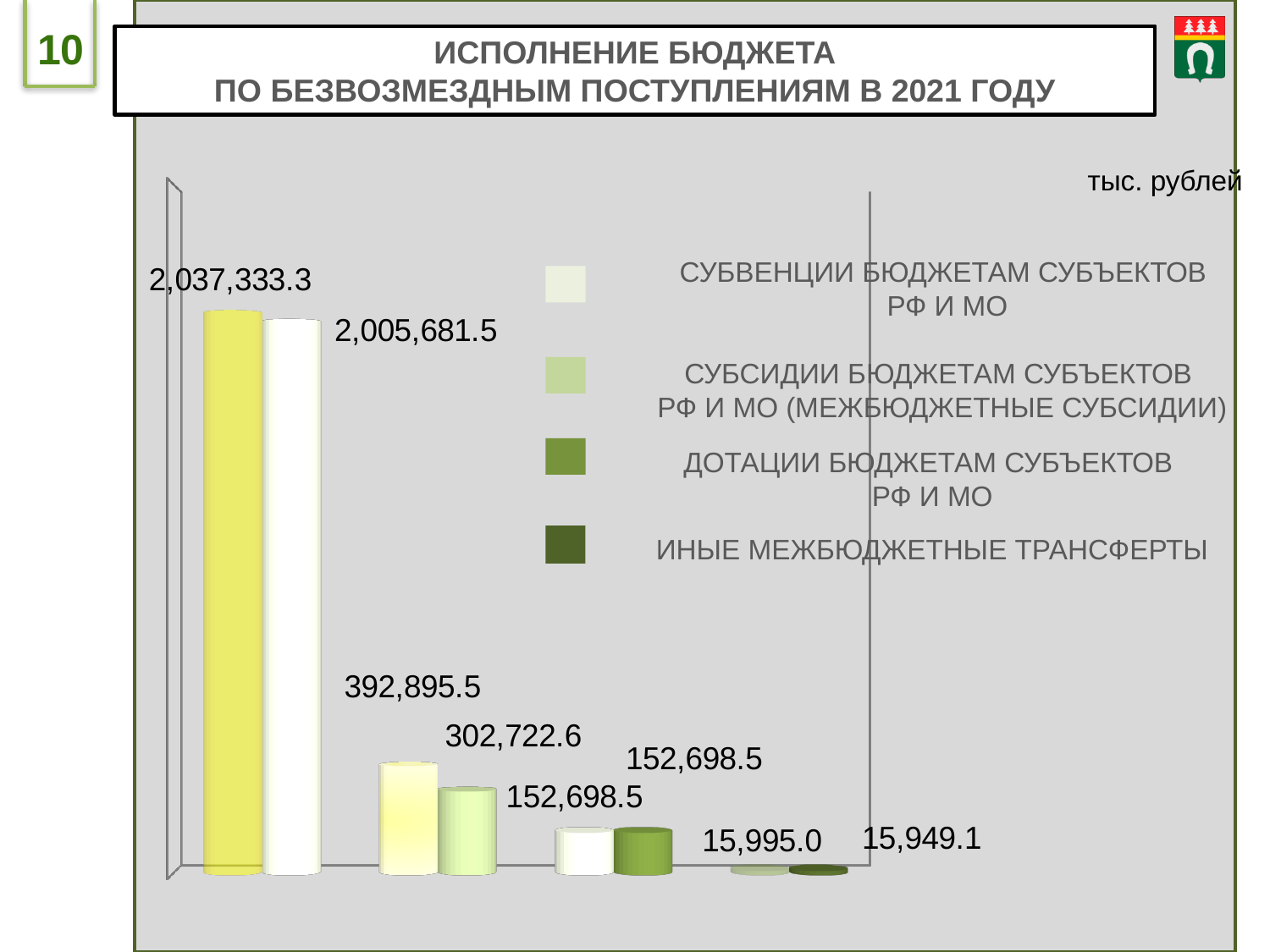
How many entries does the chart legend list? 4 What is the value of the first (left) bar for СУБСИДИИ БЮДЖЕТАМ СУБЪЕКТОВ РФ И МО (МЕЖБЮДЖЕТНЫЕ СУБСИДИИ)? 392,895.5 What is the value of the first (left) bar for СУБВЕНЦИИ БЮДЖЕТАМ СУБЪЕКТОВ РФ И МО? 2,037,333.3 What is the value of the second (right) bar for СУБВЕНЦИИ БЮДЖЕТАМ СУБЪЕКТОВ РФ И МО? 2,005,681.5 What is the value of the second (right) bar for ИНЫЕ МЕЖБЮДЖЕТНЫЕ ТРАНСФЕРТЫ? 15,949.1 Which is larger: the first bar for СУБВЕНЦИИ БЮДЖЕТАМ СУБЪЕКТОВ РФ И МО (2,037,333.3) or the second bar (2,005,681.5)? the first bar (2,037,333.3) Which legend category has the highest values on the chart? СУБВЕНЦИИ БЮДЖЕТАМ СУБЪЕКТОВ РФ И МО What unit of measurement is indicated for the chart values? тыс. рублей What is the difference between the two bars for СУБСИДИИ БЮДЖЕТАМ СУБЪЕКТОВ РФ И МО (МЕЖБЮДЖЕТНЫЕ СУБСИДИИ), 392,895.5 and 302,722.6? 90,172.9 What is the title of the chart on the slide? ИСПОЛНЕНИЕ БЮДЖЕТА ПО БЕЗВОЗМЕЗДНЫМ ПОСТУПЛЕНИЯМ В 2021 ГОДУ Which legend category has the lowest values on the chart? ИНЫЕ МЕЖБЮДЖЕТНЫЕ ТРАНСФЕРТЫ What type of chart is shown on the slide? bar chart